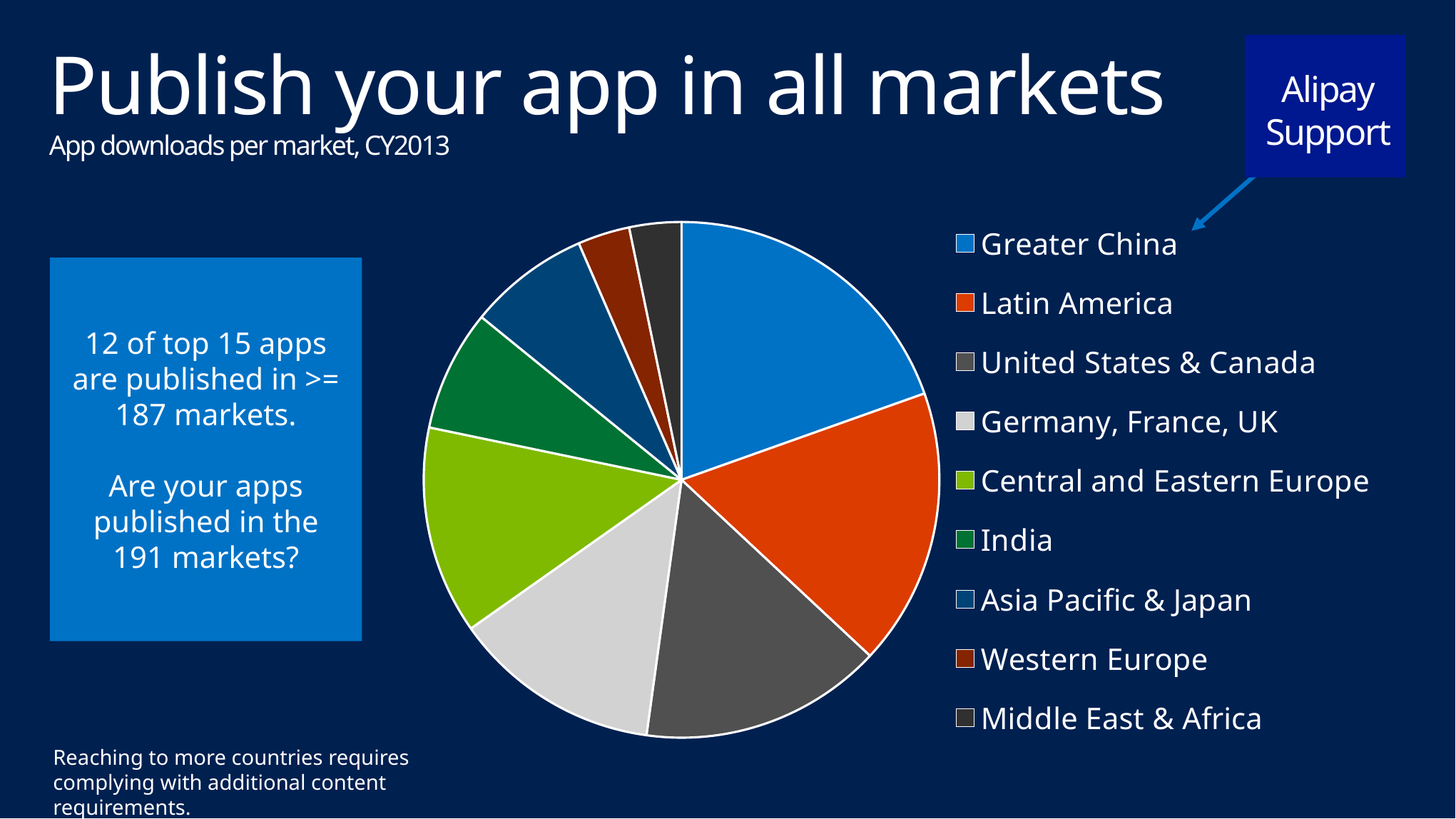
What colour is the Greater China slice in the pie chart? blue What is the subtitle describing the data in the pie chart? App downloads per market, CY2013 Which market has the largest slice of the pie chart? Greater China Which slice is larger, Central and Eastern Europe or Western Europe? Central and Eastern Europe Which slice is larger, United States & Canada or Asia Pacific & Japan? United States & Canada What kind of chart is shown on the slide? pie chart How many markets (slices) does the pie chart show? 9 Which slice is larger, Greater China or India? Greater China